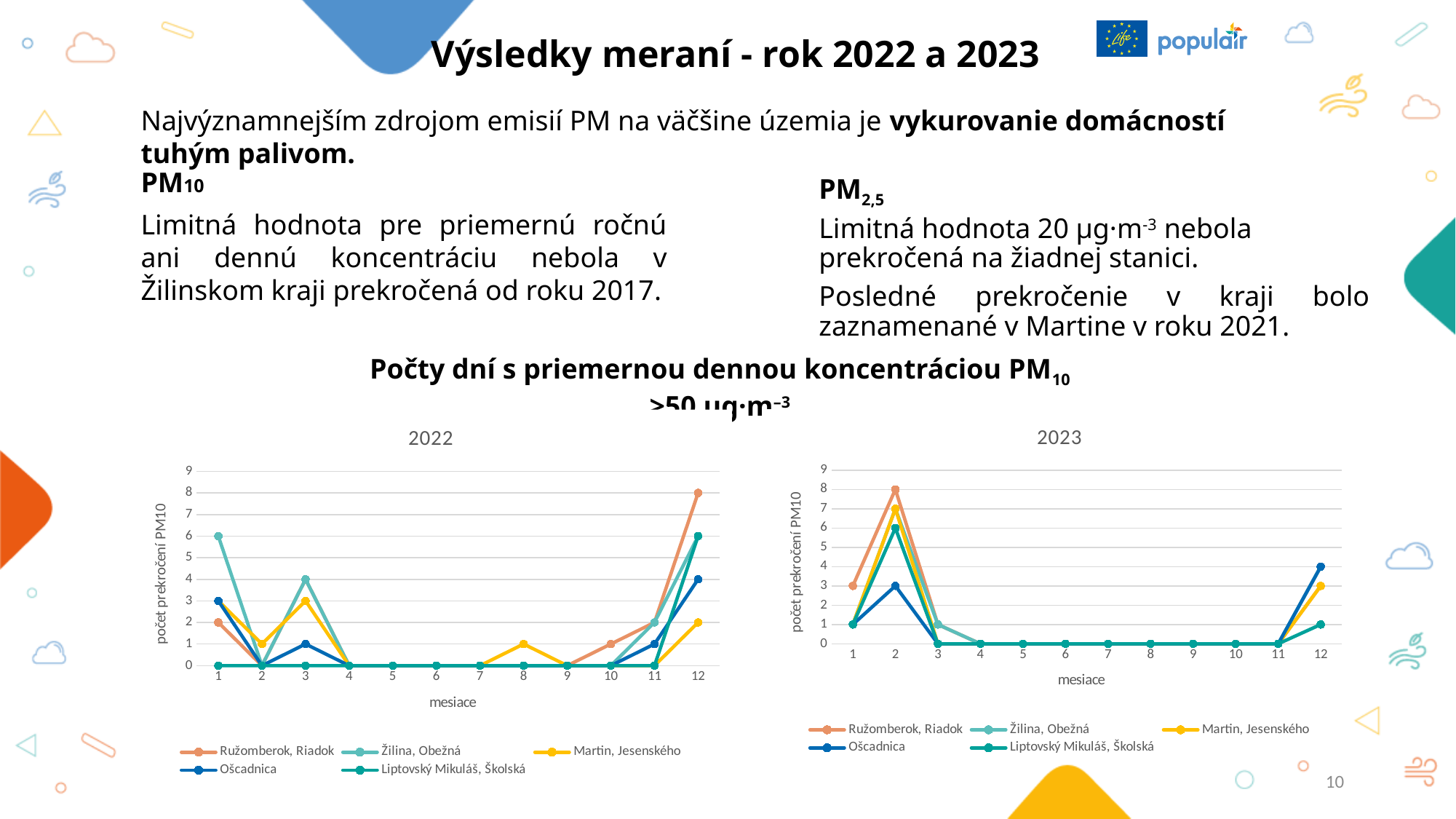
In the 2023 chart, what is the value for Ružomberok, Riadok in month 2? 8 In the 2023 chart, what is the difference between Ružomberok, Riadok and Oščadnica in month 2? 5 In the 2023 chart, what is the value for Oščadnica in month 2? 3 What kind of chart is the 2022 chart? line chart What is the label of the y axis on the 2022 chart? počet prekročení PM10 In the 2022 chart, which station has the highest value in month 12? Ružomberok, Riadok How many series does the legend of the 2023 chart list? 5 In the 2022 chart, what is the value for Žilina, Obežná in month 1? 6 In the 2023 chart, which station has the highest value in month 2? Ružomberok, Riadok How many months are shown on the x axis of the 2022 chart? 12 In the 2022 chart, which is larger in month 3: Žilina, Obežná or Oščadnica? Žilina, Obežná In the 2022 chart, what is the value for Ružomberok, Riadok in month 12? 8